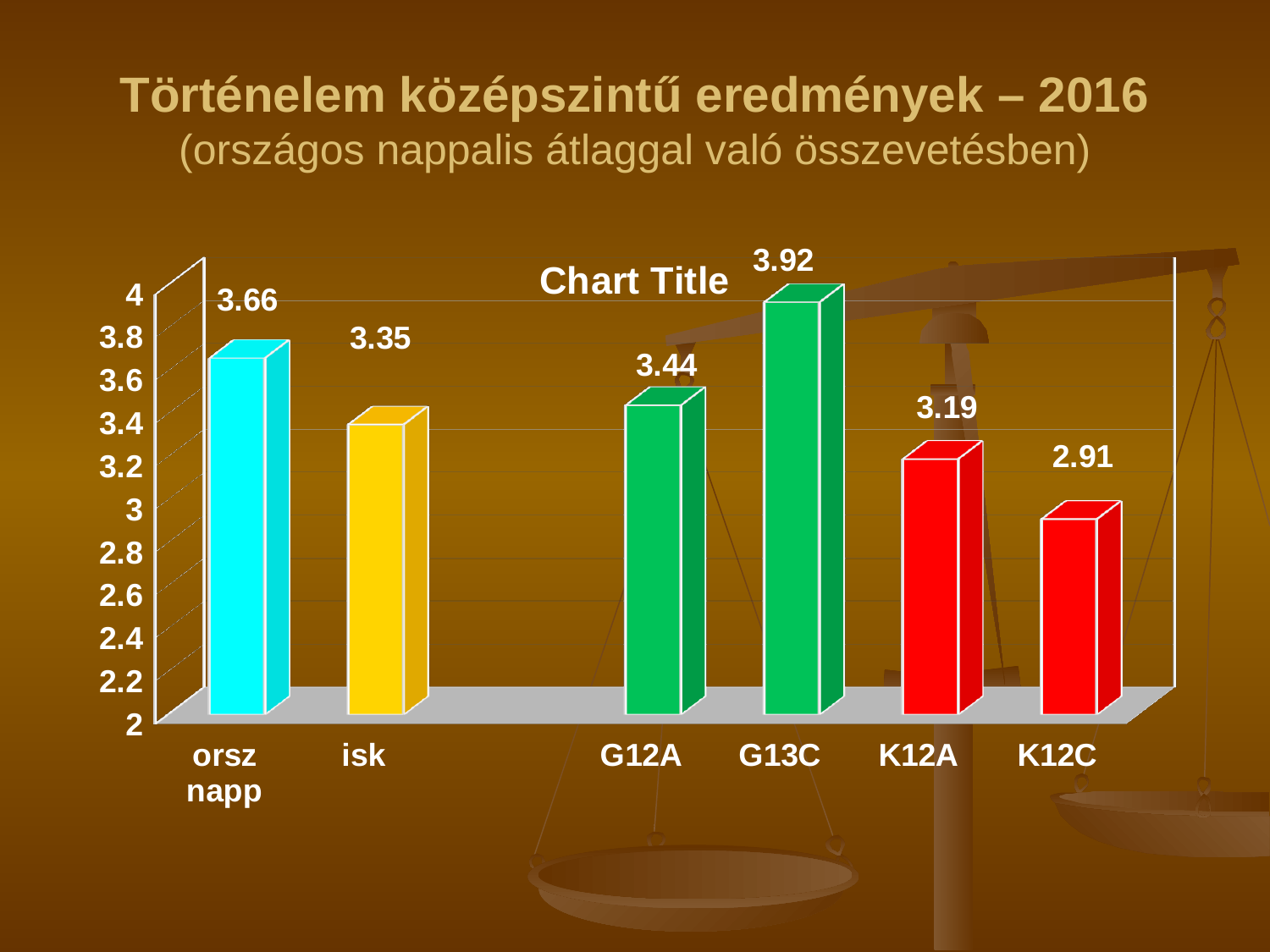
How many categories are shown on the chart? 6 What is the difference between the values for G13C and K12A? 0.73 Which is larger, the value for G12A or the value for K12A? G12A What is the value for G13C? 3.92 What is the value for isk? 3.35 Which category has the lowest value? K12C What is the difference between the values for orsz napp and isk? 0.31 What is the title printed inside the chart area? Chart Title What kind of chart is shown on the slide? bar chart What is the value for K12C? 2.91 What is the value for orsz napp? 3.66 Which category has the highest value? G13C